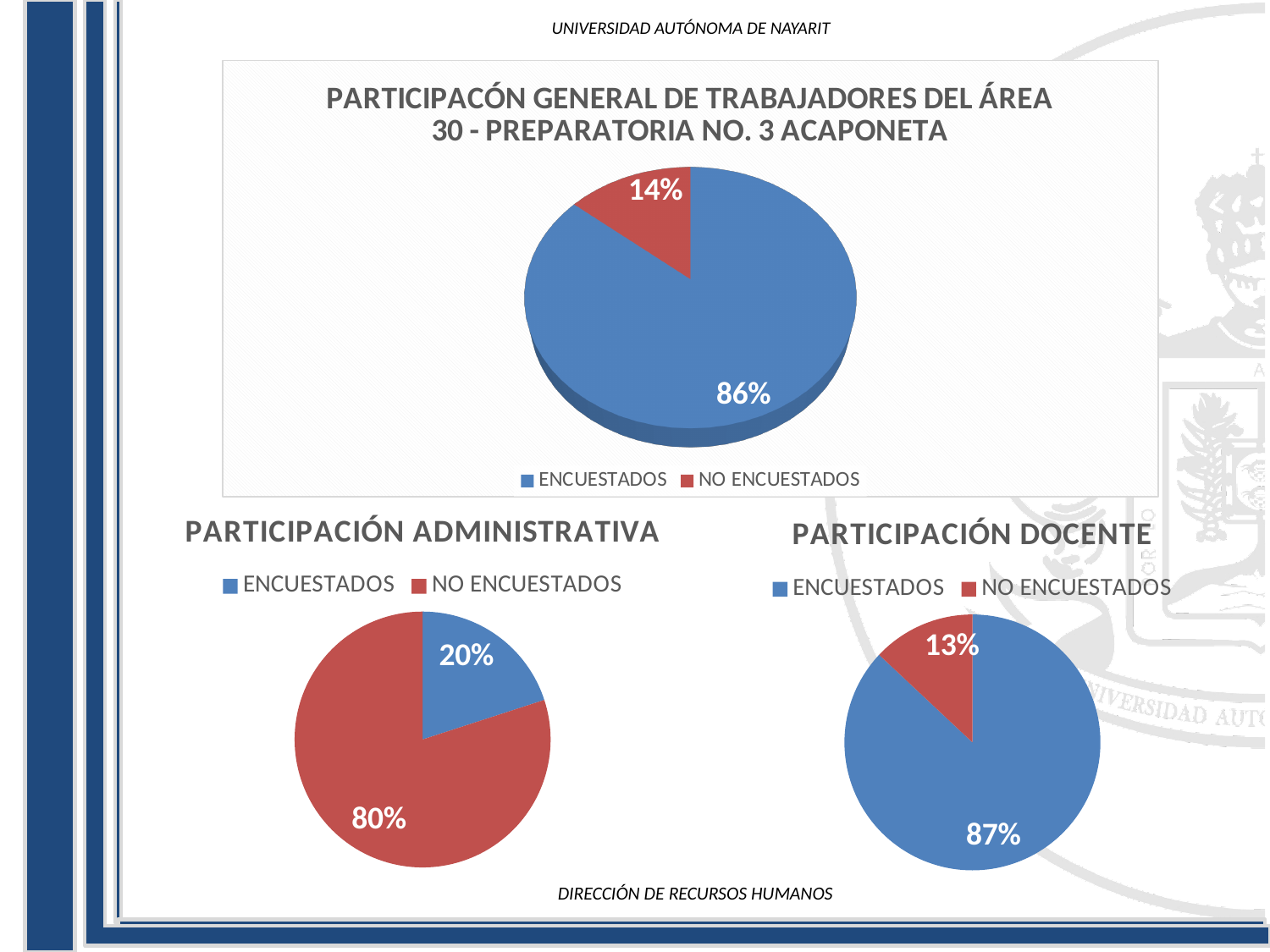
How many entries does the legend of the chart titled 'PARTICIPACIÓN ADMINISTRATIVA' list? 2 In the chart titled 'PARTICIPACÓN GENERAL DE TRABAJADORES DEL ÁREA 30 - PREPARATORIA NO. 3 ACAPONETA', what share of the pie is ENCUESTADOS? 86% In the chart titled 'PARTICIPACIÓN DOCENTE', what share of the pie is NO ENCUESTADOS? 13% In the chart titled 'PARTICIPACIÓN DOCENTE', which is larger, ENCUESTADOS or NO ENCUESTADOS? ENCUESTADOS In the chart titled 'PARTICIPACIÓN ADMINISTRATIVA', which slice is the largest? NO ENCUESTADOS In the chart titled 'PARTICIPACIÓN DOCENTE', which slice is the smallest? NO ENCUESTADOS In the chart titled 'PARTICIPACIÓN DOCENTE', what share of the pie is ENCUESTADOS? 87% What type of chart is the chart titled 'PARTICIPACIÓN DOCENTE'? Pie chart In the chart titled 'PARTICIPACIÓN ADMINISTRATIVA', what is the difference between the NO ENCUESTADOS and ENCUESTADOS shares? 60%